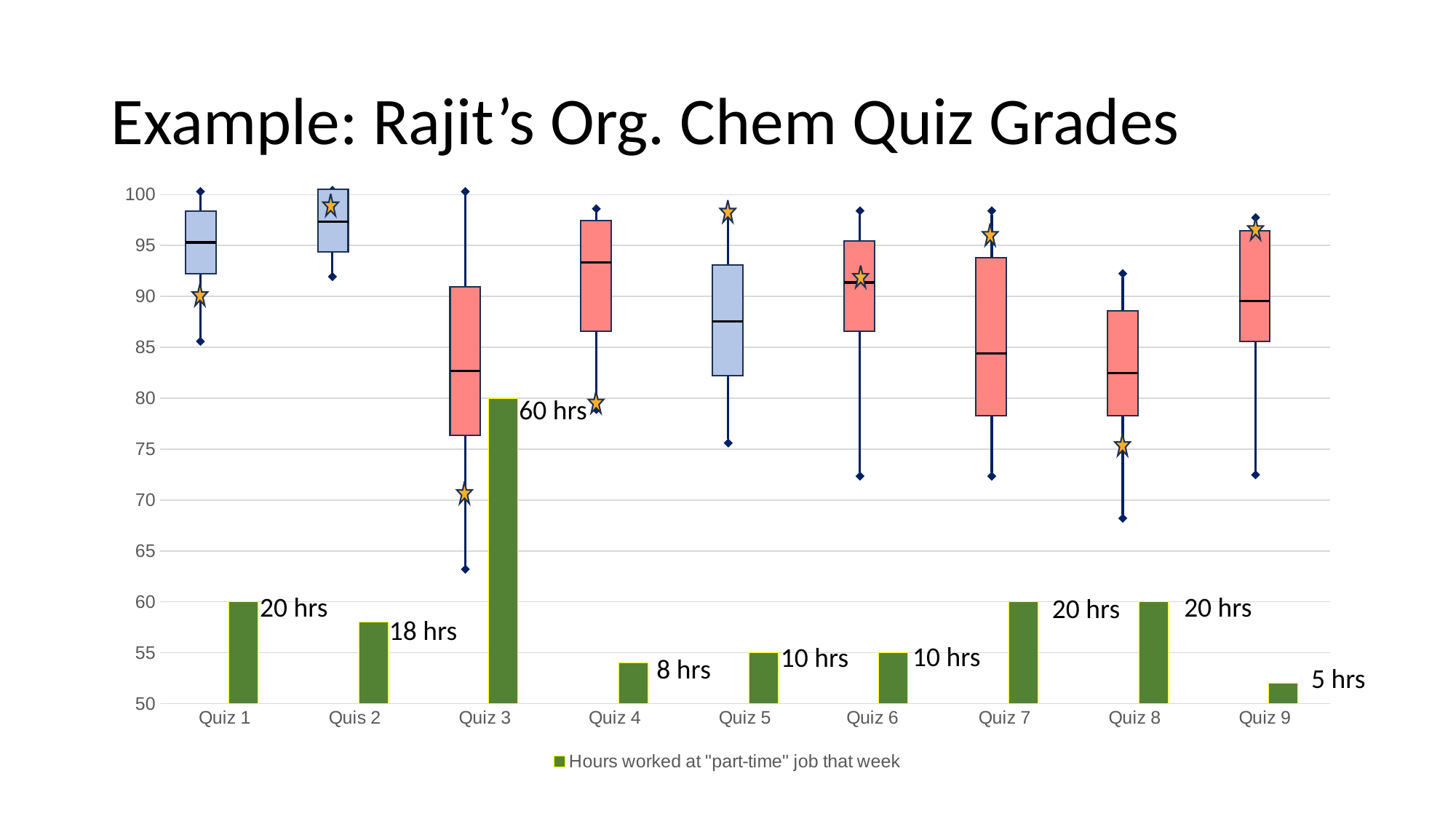
Is Rajit's grade (the star) on Quiz 3 greater or less than 75? less In which quiz week did Rajit work the most hours at his part-time job? Quiz 3 What is the title of the slide? Example: Rajit's Org. Chem Quiz Grades How many hours did Rajit work at his part-time job in the week of Quiz 4? 8 hrs Did Rajit work more hours in the week of Quiz 1 or the week of Quis 2? Quiz 1 How many hours did Rajit work at his part-time job in the week of Quiz 3? 60 hrs In which quiz week did Rajit work the fewest hours at his part-time job? Quiz 9 How many quizzes are shown along the x axis? 9 How many series does the legend list? 1 Is Rajit's grade (the star) on Quis 2 greater or less than 95? greater How many more hours did Rajit work in the week of Quiz 3 than in the week of Quiz 9? 55 hrs How many hours did Rajit work at his part-time job in the week of Quiz 9? 5 hrs